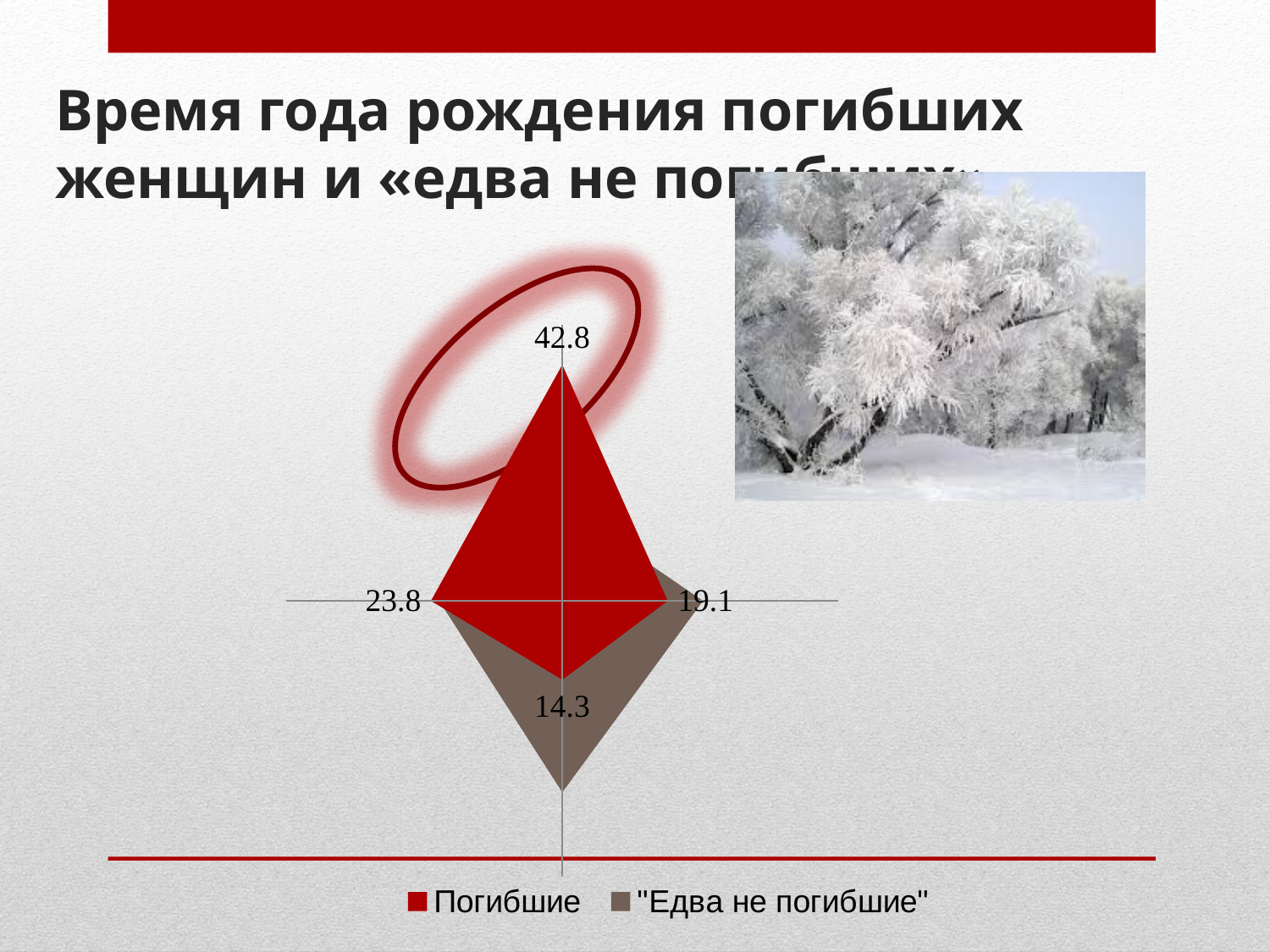
What is the lowest data label printed on the chart? 14.3 What is the highest data label printed on the chart? 42.8 What is the difference between the highest printed value (42.8) and the lowest printed value (14.3)? 28.5 What are the two series named in the chart legend? Погибшие and "Едва не погибшие" On the bottom axis of the chart, which series extends further from the centre? "Едва не погибшие" What value is printed at the top point of the chart? 42.8 What kind of chart is shown on the slide? radar chart What is the difference between the value labelled on the left axis (23.8) and the value labelled on the right axis (19.1)? 4.7 How many axes (data points per series) does the radar chart have? 4 What colour is used for the "Погибшие" series in the chart? red Which is larger: the value labelled on the top axis or the value labelled on the bottom axis? the top axis (42.8) How many series does the chart legend list? 2